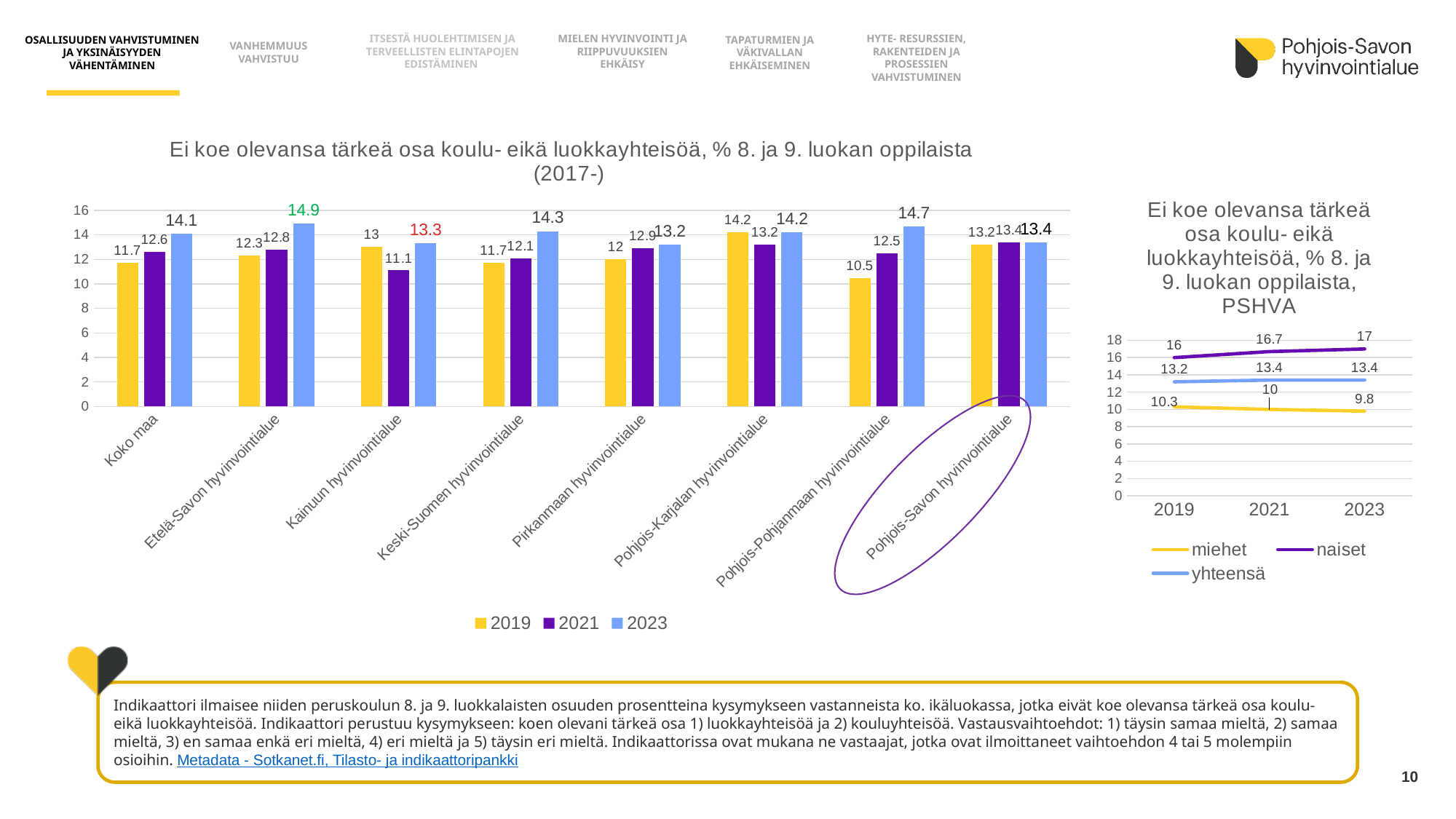
In the bar chart on the left, what is the 2023 value for Etelä-Savon hyvinvointialue? 14.9 What kind of chart is the chart on the right (PSHVA)? line chart In the bar chart on the left, what is the difference between the 2023 and 2019 values for Koko maa? 2.4 How many regions are shown on the x axis of the bar chart on the left? 8 In the bar chart on the left, what is the 2019 value for Pohjois-Pohjanmaan hyvinvointialue? 10.5 In the line chart on the right (PSHVA), does the miehet line rise or fall from 2019 to 2023? fall In the line chart on the right (PSHVA), what is the value for miehet in 2019? 10.3 In the bar chart on the left, which region has the lowest 2019 value? Pohjois-Pohjanmaan hyvinvointialue In the line chart on the right (PSHVA), what is the value for naiset in 2023? 17 In the bar chart on the left, which region has the highest 2023 value? Etelä-Savon hyvinvointialue How many series does the legend of the bar chart on the left list? 3 In the bar chart on the left, which is larger for Kainuun hyvinvointialue: the 2019 value or the 2021 value? 2019